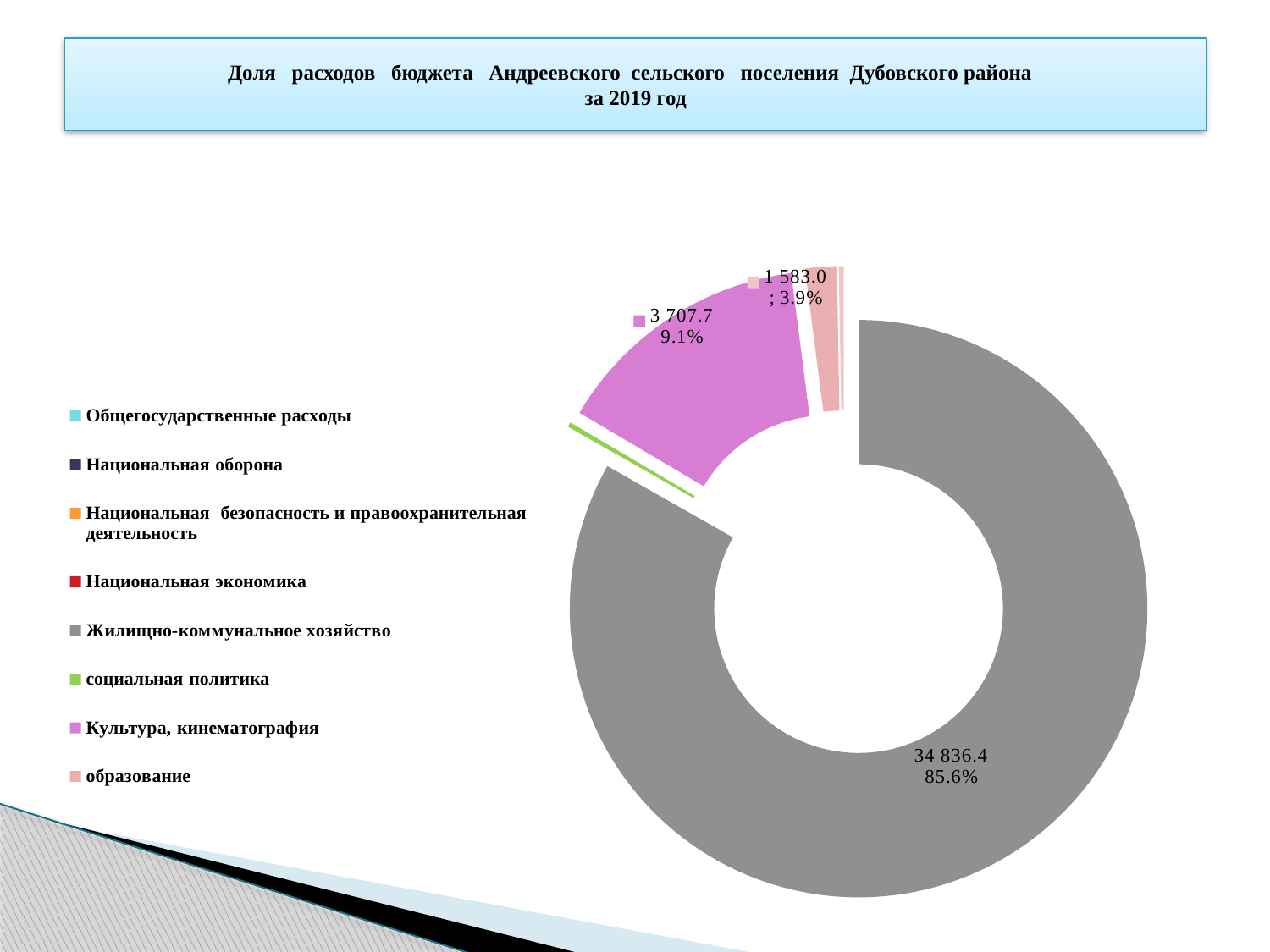
How many categories does the legend of the chart list? 8 What value is shown for Культура, кинематография? 3 707.7 Which category has the largest slice of the pie? Жилищно-коммунальное хозяйство What value is shown for образование? 1 583.0 What is the difference between the values for Культура, кинематография and образование? 2 124.7 What share of the pie does Жилищно-коммунальное хозяйство take? 85.6% What year does the chart title say the budget expenditure shares are for? 2019 Which is larger, the value for Культура, кинематография or the value for образование? Культура, кинематография What share of the pie does Культура, кинематография take? 9.1% What value is shown for Жилищно-коммунальное хозяйство? 34 836.4 What share of the pie does образование take? 3.9% What kind of chart is shown on the slide? Pie chart (doughnut)